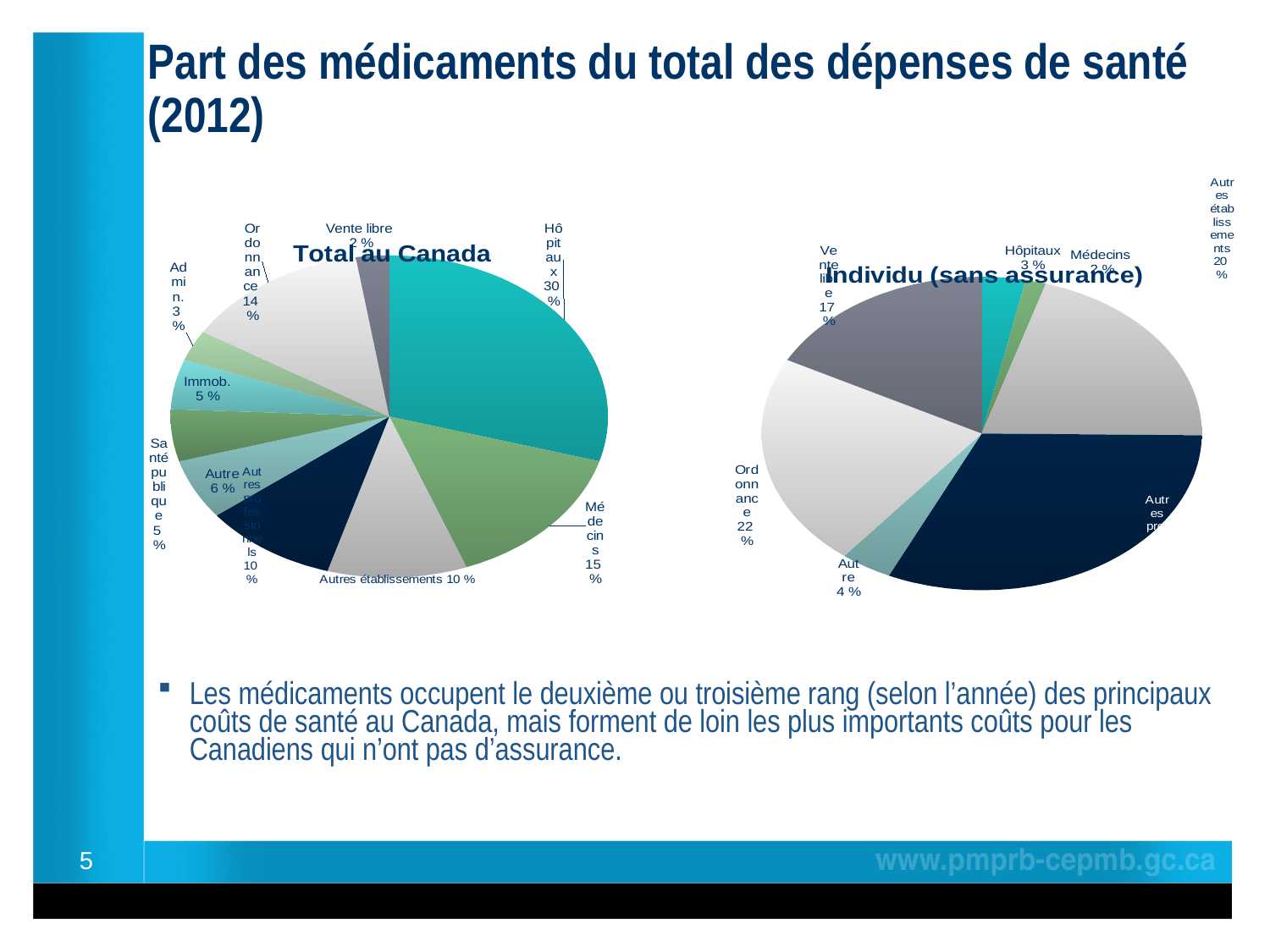
In the "Individu (sans assurance)" chart, what share do Médecins represent? 2 % How much larger is the Ordonnance share in the "Individu (sans assurance)" chart than in the "Total au Canada" chart? 8 % In the "Individu (sans assurance)" chart, what share do Autres établissements represent? 20 % What kind of chart is the "Total au Canada" chart? pie chart In the "Total au Canada" chart, what share does Ordonnance represent? 14 % In the "Total au Canada" chart, what share do Hôpitaux represent? 30 % In the "Individu (sans assurance)" chart, which is larger: Ordonnance or Vente libre? Ordonnance What is the title of the pie chart on the left of the slide? Total au Canada In the "Total au Canada" chart, what is the difference between the Hôpitaux share and the Médecins share? 15 % In the "Individu (sans assurance)" chart, what share does Vente libre represent? 17 % In the "Total au Canada" chart, which category has the largest share? Hôpitaux In the "Individu (sans assurance)" chart, what share does Ordonnance represent? 22 %